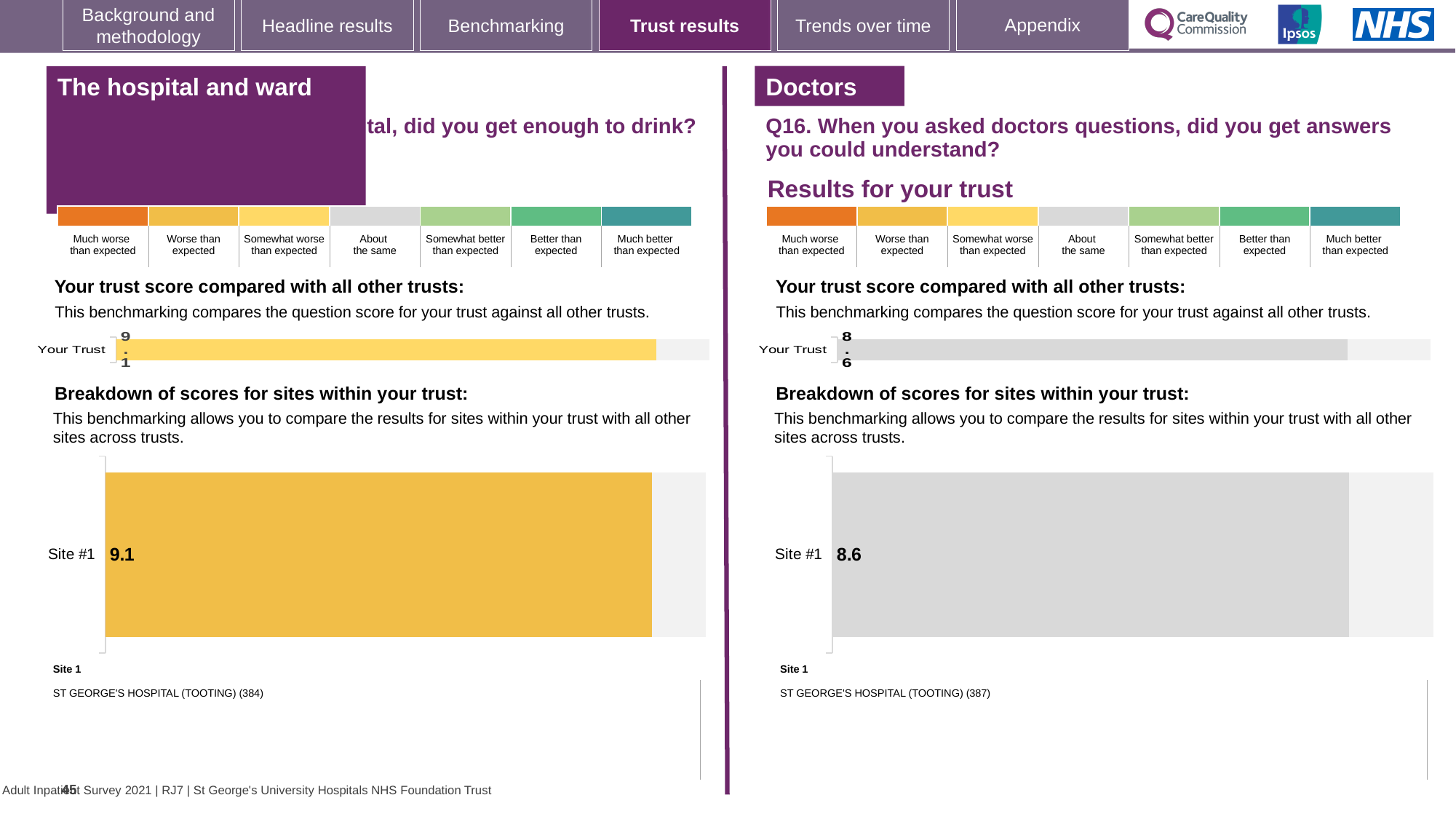
On the right-hand side of the slide (Doctors, Q16), what is the score shown for Your Trust? 8.6 Which site is listed as Site 1 beneath the right-hand breakdown chart? ST GEORGE'S HOSPITAL (TOOTING) (387) What colour is the Site #1 bar in the right-hand (Doctors) breakdown chart? Grey Which is larger: the Your Trust score on the left-hand side of the slide or the Your Trust score on the right-hand side (Q16)? Left-hand side (9.1) What colour is the Site #1 bar in the left-hand (The hospital and ward) breakdown chart? Yellow What is the difference between the Site #1 score on the left-hand chart and the Site #1 score on the right-hand chart? 0.5 In the left-hand 'Breakdown of scores for sites within your trust' chart, what is the value for Site #1? 9.1 On the left-hand side of the slide (The hospital and ward), what is the score shown for Your Trust? 9.1 How many sites are shown in the left-hand 'Breakdown of scores for sites within your trust' chart? 1 How many sites are shown in the right-hand 'Breakdown of scores for sites within your trust' chart? 1 What type of chart is used to show the Site #1 score on the left-hand side of the slide? Bar chart In the right-hand 'Breakdown of scores for sites within your trust' chart, what is the value for Site #1? 8.6